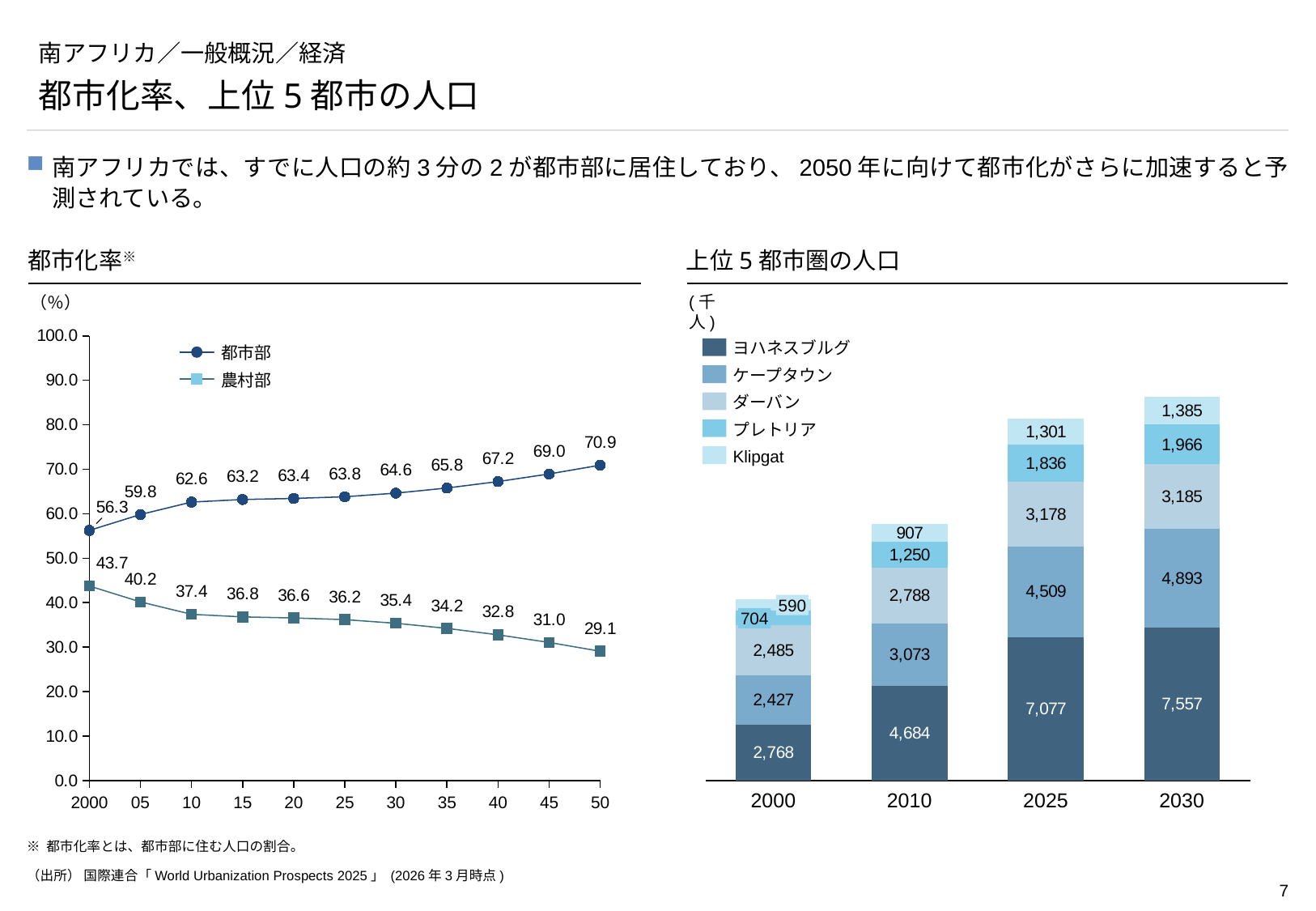
In the 上位5都市圏の人口 chart, what is the total of the stacked bar for 2030? 18,986 In the 都市化率 chart, how many data points does each series have? 11 In the 上位5都市圏の人口 chart, how many series does the legend list? 5 In the 上位5都市圏の人口 chart, what is the value for プレトリア in 2010? 1,250 In the 都市化率 chart, how many series does the legend list? 2 What kind of chart is the 上位5都市圏の人口 chart? stacked bar chart In the 上位5都市圏の人口 chart, what is the value for ヨハネスブルグ in 2030? 7,557 In the 上位5都市圏の人口 chart, which is larger in 2000, ケープタウン or ダーバン? ダーバン In the 都市化率 chart, what is the difference between 都市部 and 農村部 in 2050? 41.8 In the 都市化率 chart, what is the value for 農村部 in 2000? 43.7 In the 都市化率 chart, does the 農村部 series rise or fall from 2000 to 2050? fall In the 都市化率 chart, what is the value for 都市部 in 2050? 70.9